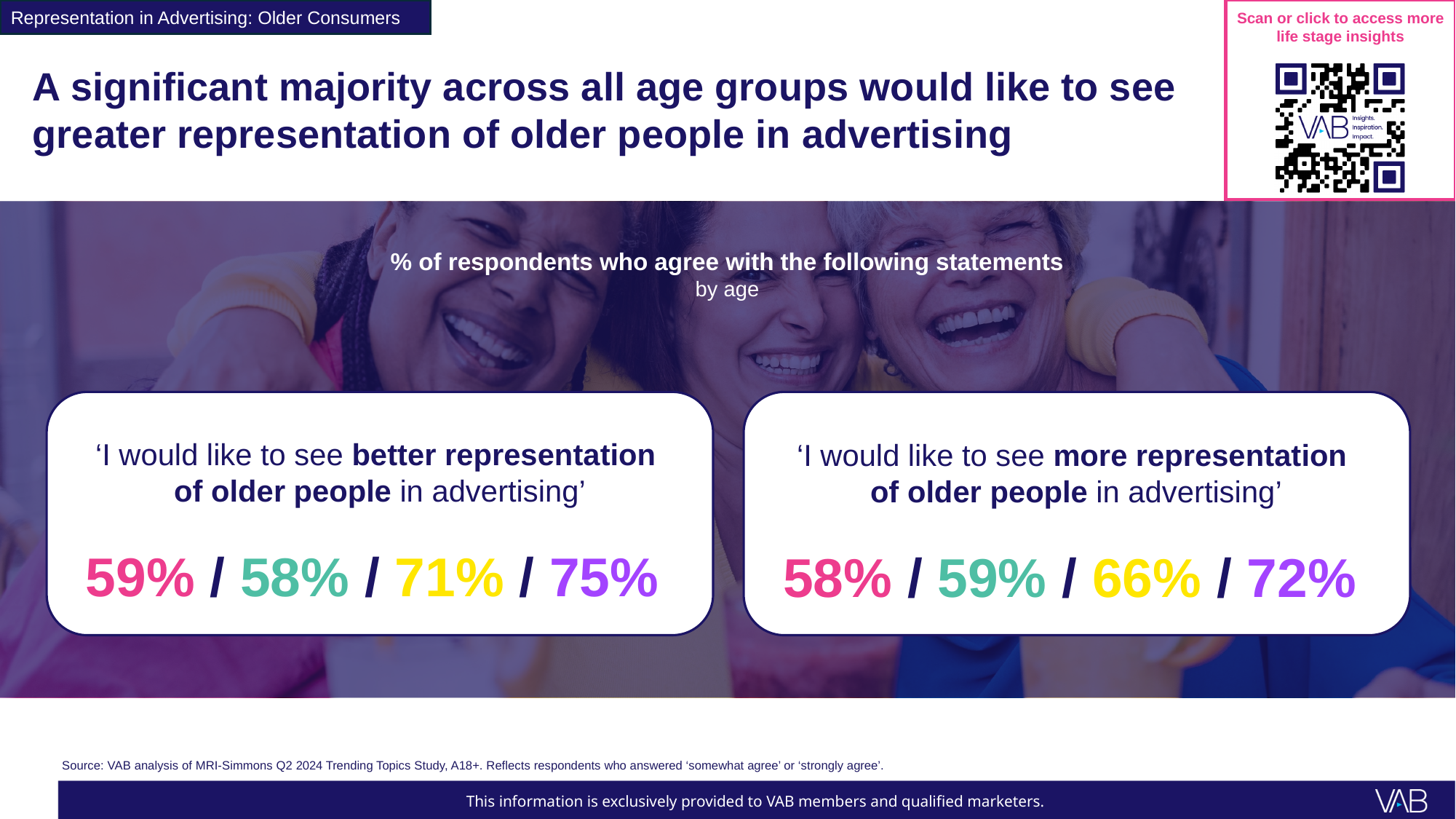
How many percentage values are listed for the 'better representation' statement? 4 What is the highest percentage shown for the statement 'I would like to see more representation of older people in advertising'? 72% What does the subtitle above the two boxes say the percentages represent? % of respondents who agree with the following statements, by age What is the highest percentage shown for the statement 'I would like to see better representation of older people in advertising'? 75% What is the third percentage listed (in yellow) for the 'more representation' statement? 66% What is the difference between the highest percentage for the 'better representation' statement and the highest percentage for the 'more representation' statement? 3 percentage points What is the lowest percentage shown for the statement 'I would like to see more representation of older people in advertising'? 58% How many percentage values are listed for the 'more representation' statement? 4 What is the third percentage listed (in yellow) for the 'better representation' statement? 71% What is the lowest percentage shown for the statement 'I would like to see better representation of older people in advertising'? 58% How many statements are shown on the slide? 2 Which statement has the higher top percentage: 'better representation' or 'more representation'? better representation